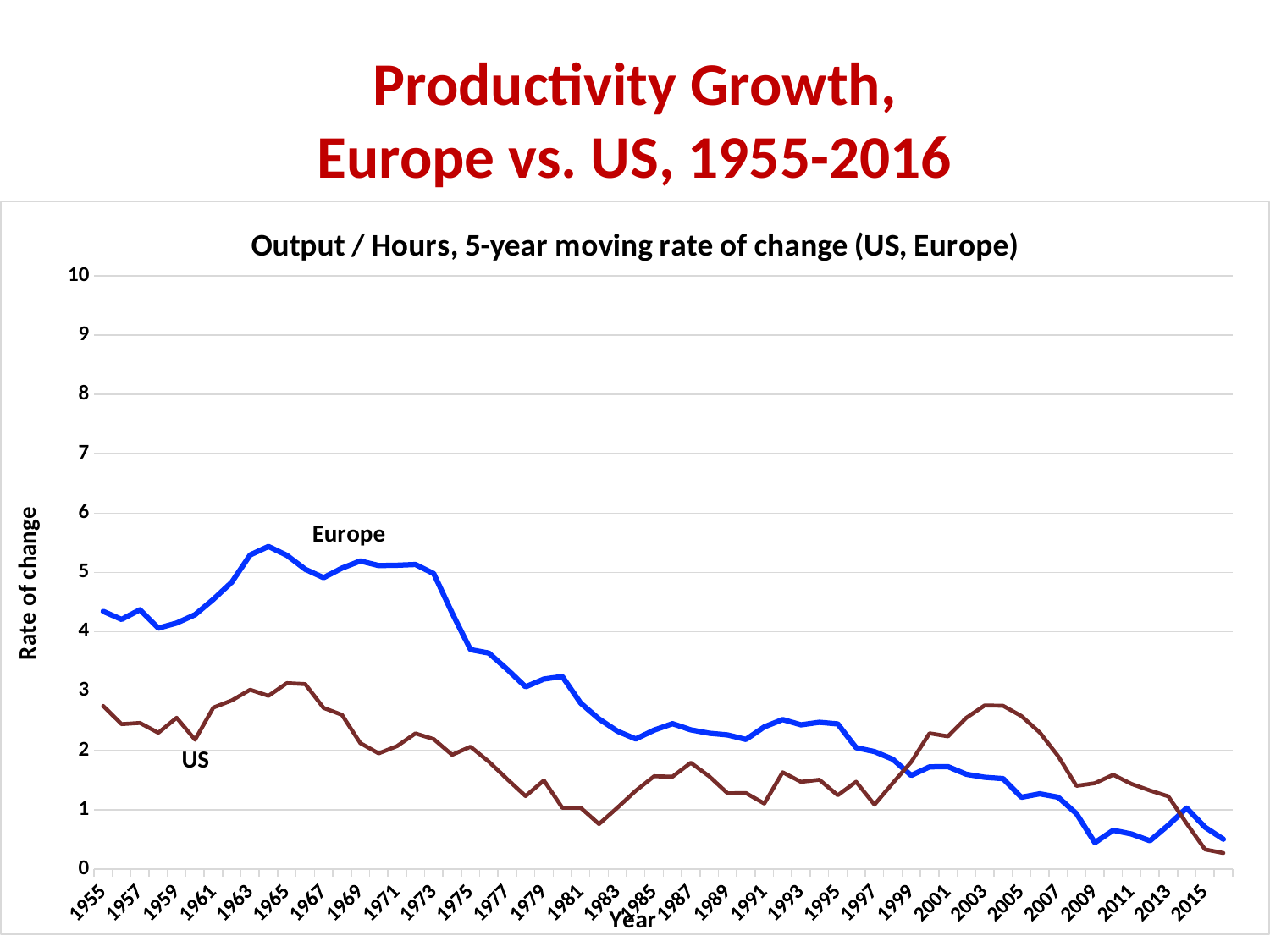
Is the value for Europe in 1965 greater or less than 5? greater How many series (lines) are plotted on the chart? 2 Overall, does the Europe line rise or fall from 1955 to 2016? fall Is the value for the US in 2003 greater or less than 2? greater Is the value for Europe in 2009 greater or less than 1? less What is the label on the vertical axis of the chart? Rate of change What is the title of the chart? Output / Hours, 5-year moving rate of change (US, Europe) In 2003, which series has the higher value, Europe or the US? US In 1965, which series has the higher value, Europe or the US? Europe What kind of chart is shown on the slide? line chart